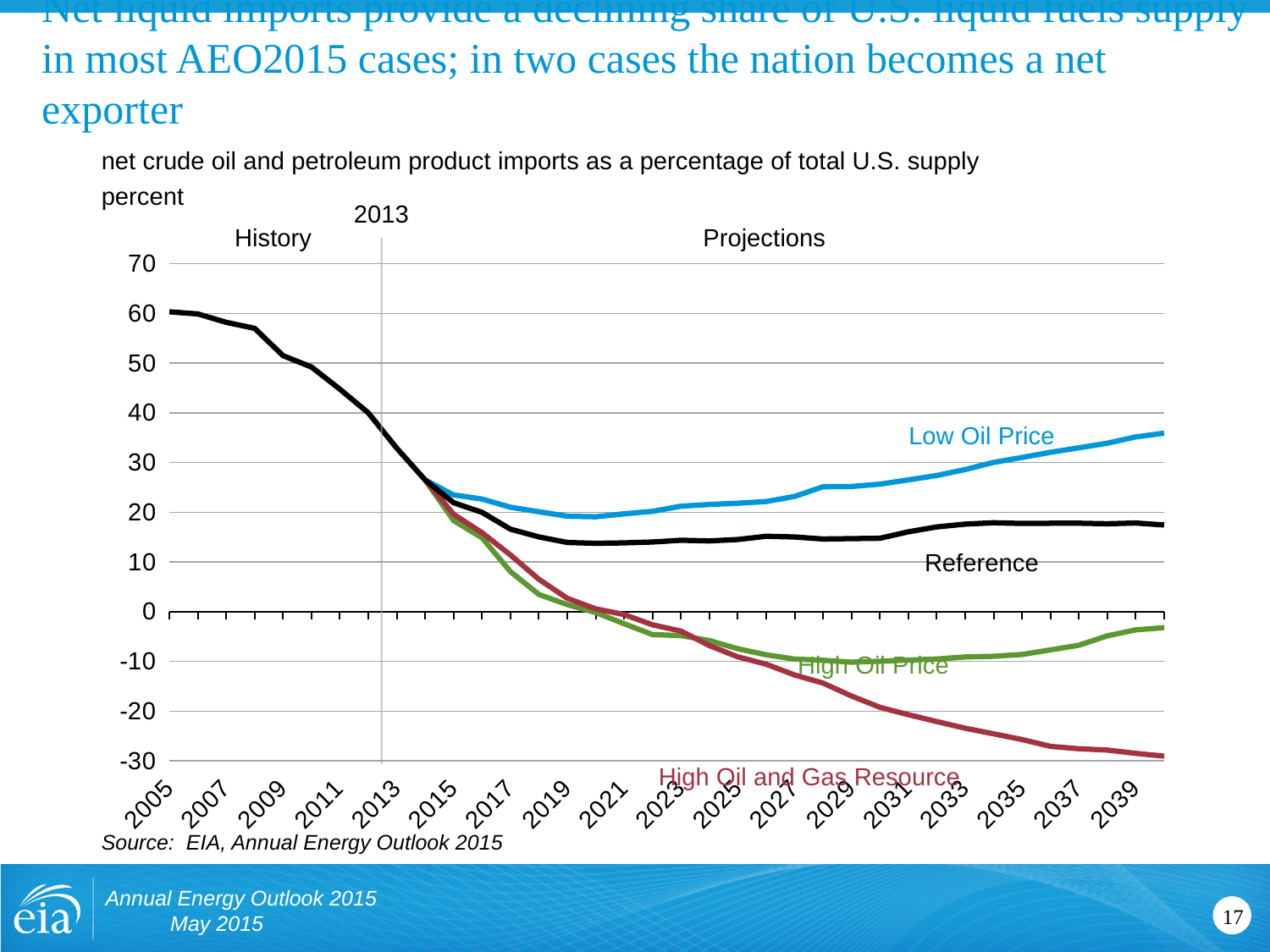
What unit is the y axis measured in? percent Which series has the highest value in 2039? Low Oil Price Is the value for Low Oil Price in 2039 greater or less than 30? greater What kind of chart is shown on the slide? line chart Which series has the lowest value in 2039? High Oil and Gas Resource Is the value for Reference in 2039 greater or less than 20? less How many projection series are labeled on the chart? 4 Is the value in 2005 greater or less than 50? greater Do the values fall or rise from 2005 to 2013? fall Which year marks the boundary between History and Projections on the chart? 2013